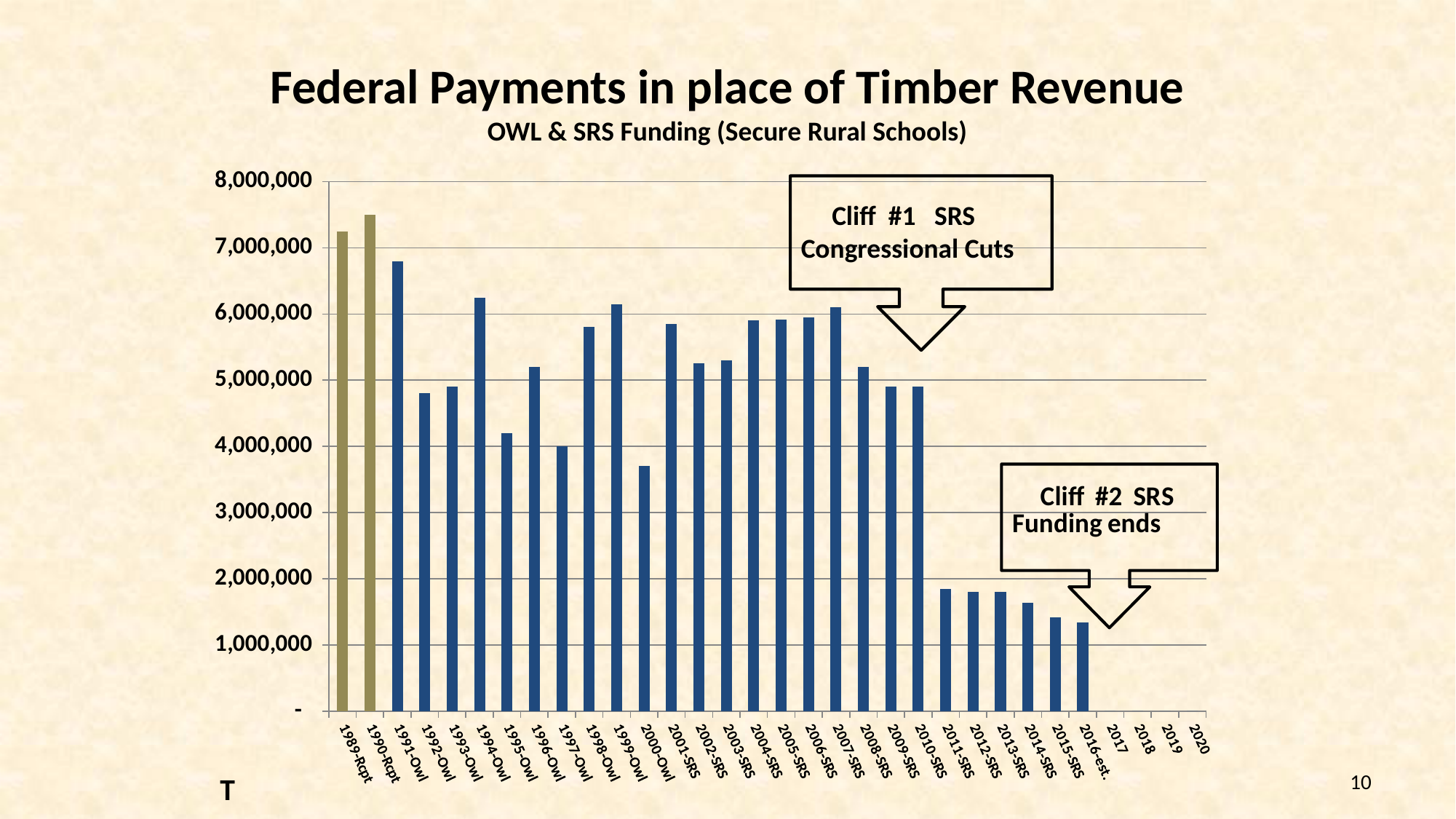
Which is larger, the value for 1991-Owl or the value for 1992-Owl? 1991-Owl Is the value for 2000-Owl greater or less than 4,000,000? less Do the values rise or fall from 2011-SRS to 2016-est.? fall What kind of chart is shown on the slide? bar chart Which is larger, the value for 2010-SRS or the value for 2011-SRS? 2010-SRS Which category has the highest bar in the chart? 1990-Rcpt What is the subtitle shown under the chart title? OWL & SRS Funding (Secure Rural Schools) How many bars are plotted in the chart? 28 Is the value for 2011-SRS greater or less than 2,000,000? less Is the value for 1994-Owl greater or less than 6,000,000? greater